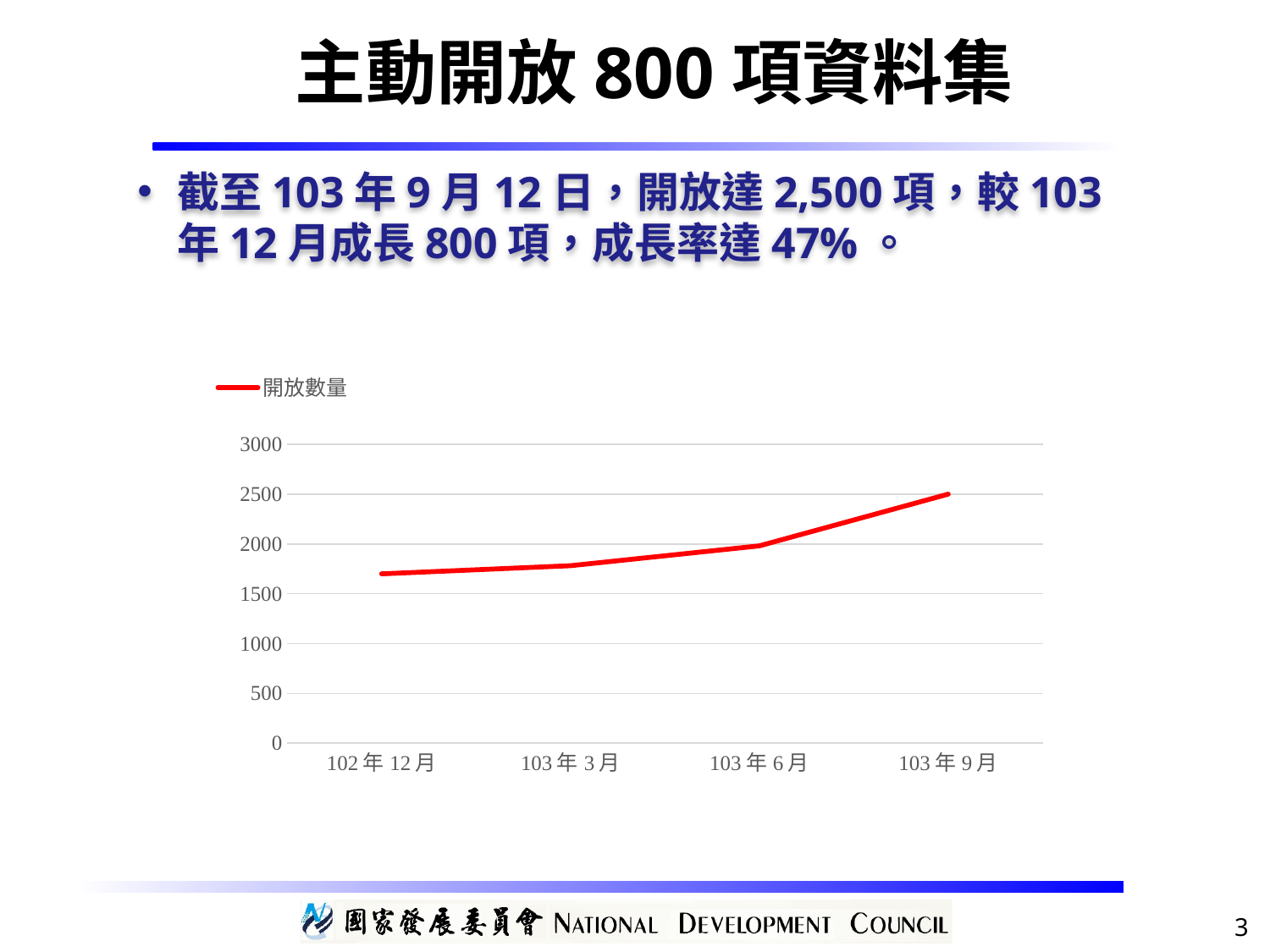
How many series does the legend list? 1 Is the value for 103年3月 greater or less than 2000? less What kind of chart is shown on the slide? line chart How many points are plotted along the x axis? 4 What is the name of the series shown in the legend? 開放數量 Is the value for 102年12月 greater or less than 1500? greater What colour is the line for 開放數量? red What is the value for 103年9月? 2500 Which category has the highest value for 開放數量? 103年9月 Which category has the lowest value for 開放數量? 102年12月 Which is larger, the value for 103年9月 or the value for 102年12月? 103年9月 Do the values rise or fall from 102年12月 to 103年9月? rise